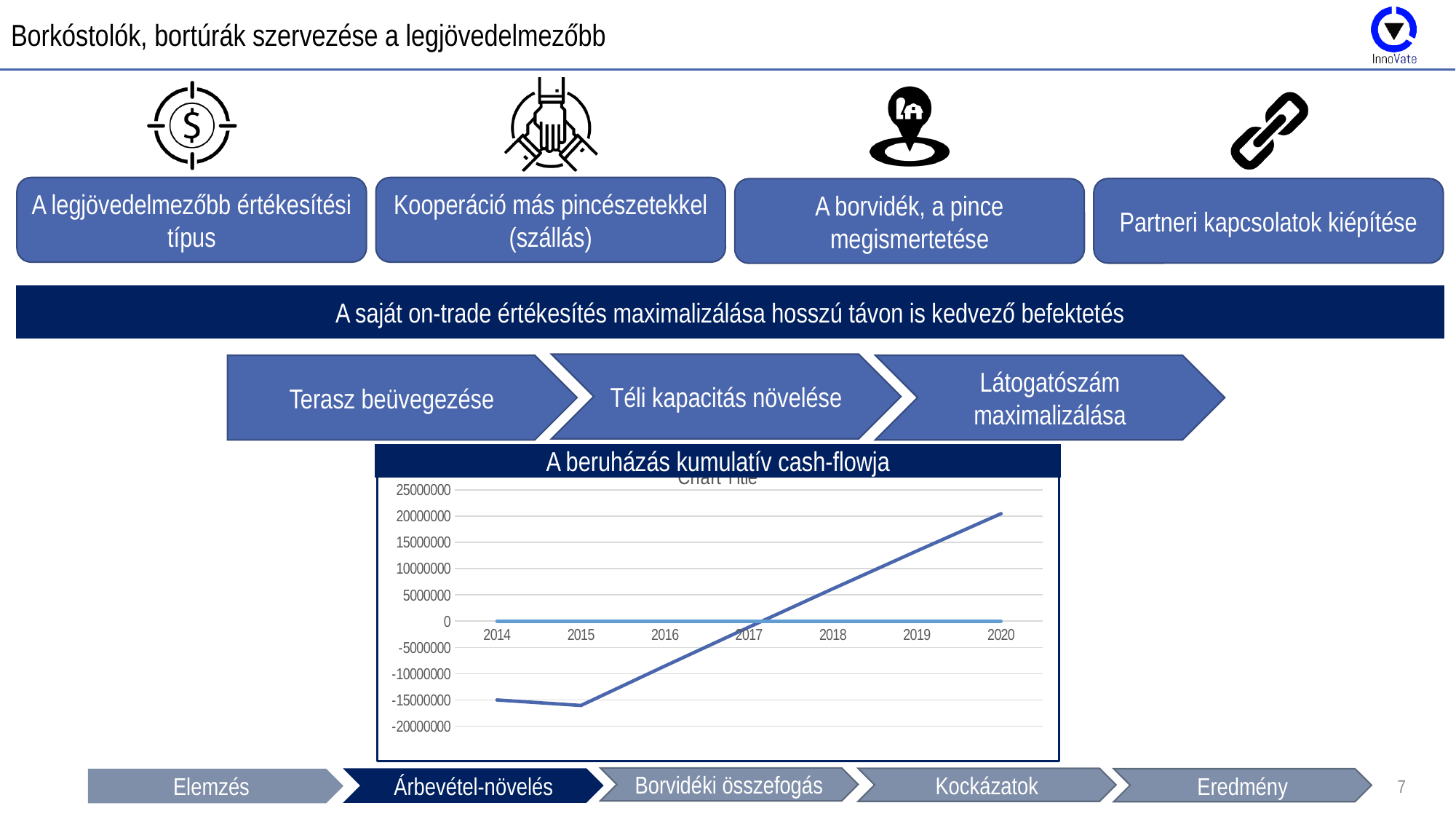
What kind of chart is shown under the heading 'A beruházás kumulatív cash-flowja'? line chart In which year does the cumulative cash-flow line reach its highest point? 2020 What is the first year shown on the x axis of the cumulative cash-flow chart? 2014 Which year has the larger cumulative cash-flow value, 2016 or 2019? 2019 Does the cumulative cash-flow line rise or fall between 2015 and 2020? rise Is the cumulative cash-flow value for 2019 greater or less than 10000000? greater Is the cumulative cash-flow value for 2016 greater or less than -5000000? less What is the highest value labelled on the y axis of the cumulative cash-flow chart? 25000000 Is the cumulative cash-flow value for 2014 greater or less than -10000000? less In which year does the cumulative cash-flow line reach its lowest point? 2015 How many years are shown on the x axis of the cumulative cash-flow chart? 7